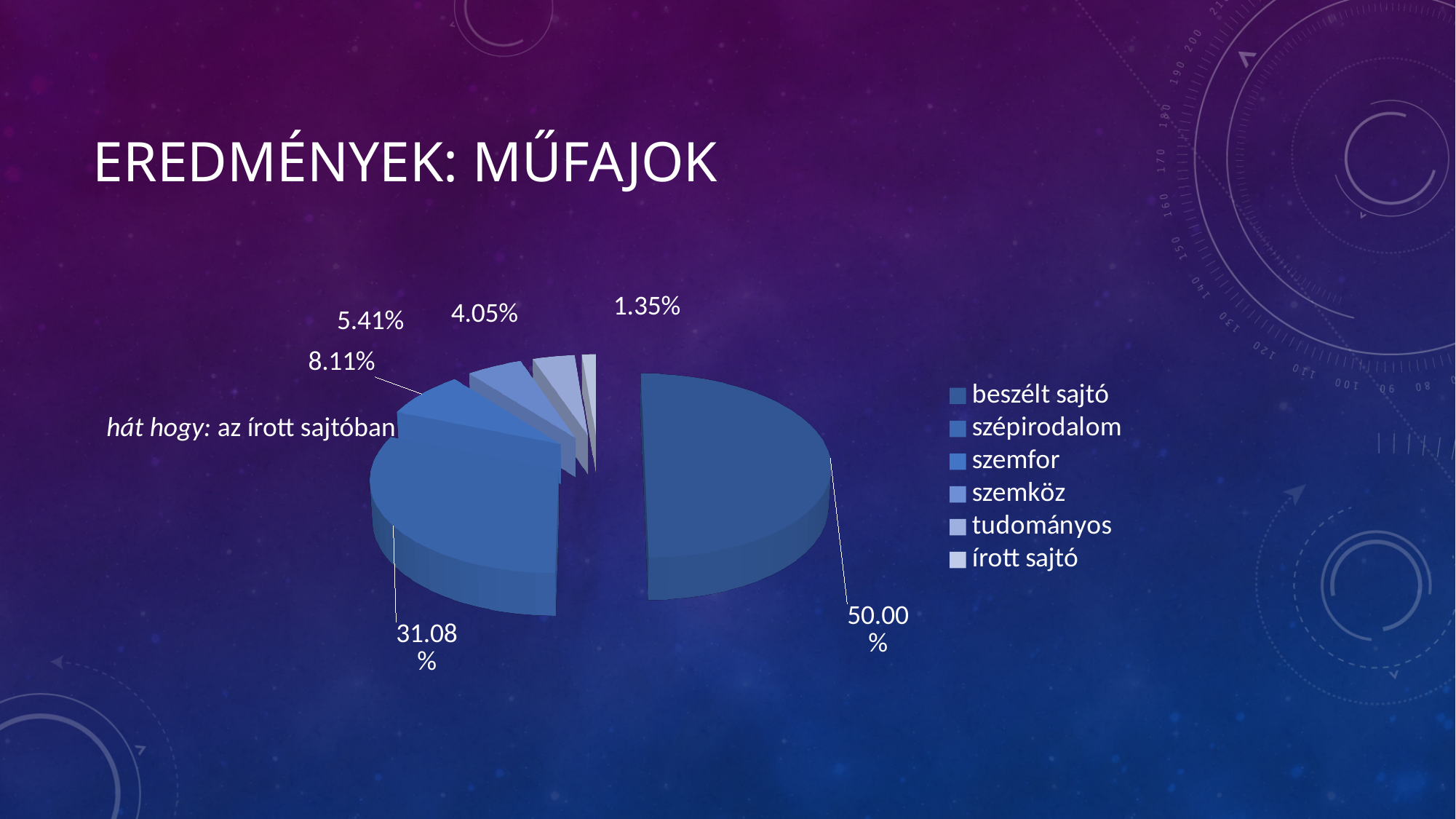
What share of the pie does beszélt sajtó have? 50.00% What kind of chart is shown on the slide? pie chart How many categories does the legend of the pie chart list? 6 What percentage is shown for írott sajtó? 1.35% Which category has the largest slice of the pie? beszélt sajtó What is the difference between the shares of beszélt sajtó and szépirodalom? 18.92% Which is larger, the share of szemköz or the share of tudományos? szemköz What share of the pie does szépirodalom have? 31.08% What is the title of the slide containing the pie chart? EREDMÉNYEK: MŰFAJOK Which category has the smallest slice of the pie? írott sajtó What percentage is shown for szemfor? 8.11% What is the difference between the shares of szemfor and szemköz? 2.70%